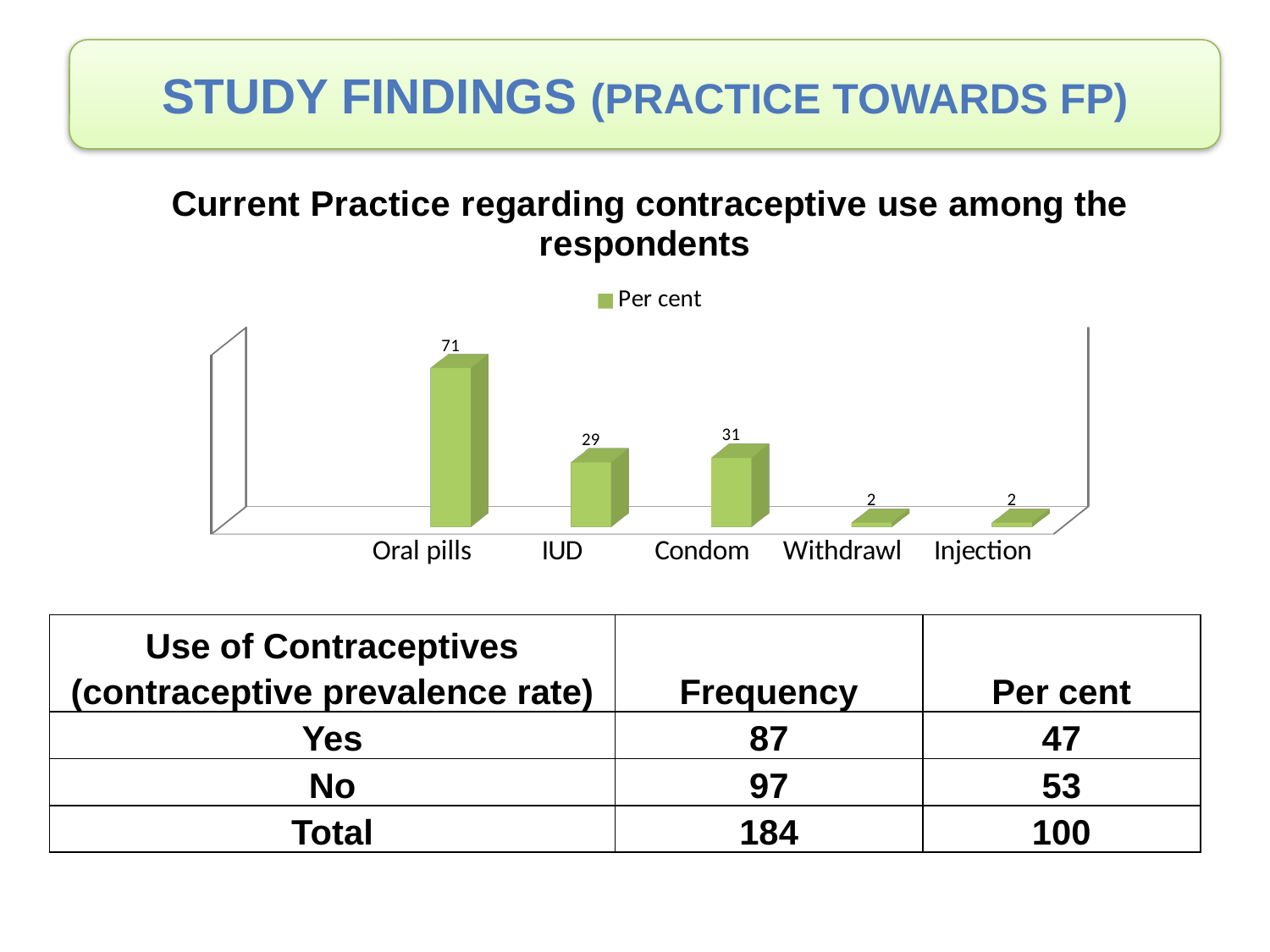
What kind of chart is shown on the slide? Bar chart What is the difference between the values for Oral pills and Condom? 40 What is the value for Withdrawl in the chart? 2 How many categories are shown on the x axis of the chart? 5 Which category has the highest value in the chart? Oral pills What is the value for IUD in the chart? 29 What is the value for Oral pills in the chart? 71 What is the difference between the values for Condom and IUD? 2 What is the name of the series shown in the chart legend? Per cent What is the value for Condom in the chart? 31 Which is larger, the value for IUD or the value for Withdrawl? IUD How many series does the chart legend list? 1